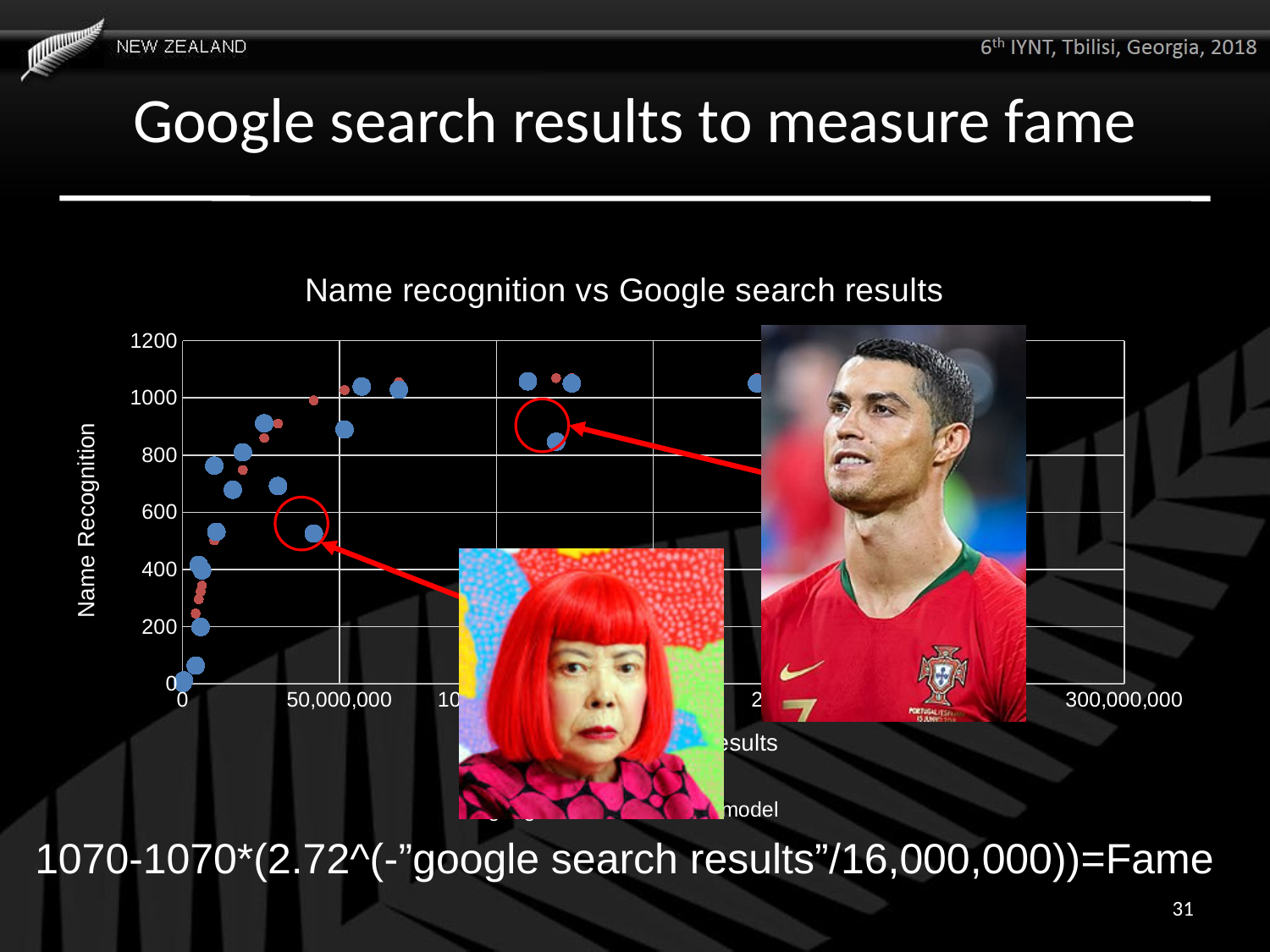
What is the title of the chart? Name recognition vs Google search results What kind of chart is shown on the slide? scatter chart Which of the two circled points has the higher Name Recognition value, the one near 40,000,000 search results or the one near 150,000,000 search results? the one near 150,000,000 search results Is the Name Recognition value of the circled point near 150,000,000 search results greater or less than 600? greater Is the Name Recognition value of the circled point near 150,000,000 search results greater or less than 1000? less What is the highest tick value shown on the horizontal axis? 300,000,000 Is the Name Recognition value of the circled point near 40,000,000 search results greater or less than 600? less What is the label of the vertical axis of the chart? Name Recognition Do the Name Recognition values generally rise or fall as Google search results increase along the x axis? rise What is the interval between consecutive tick marks on the vertical axis? 200 What is the highest tick value shown on the vertical axis? 1200